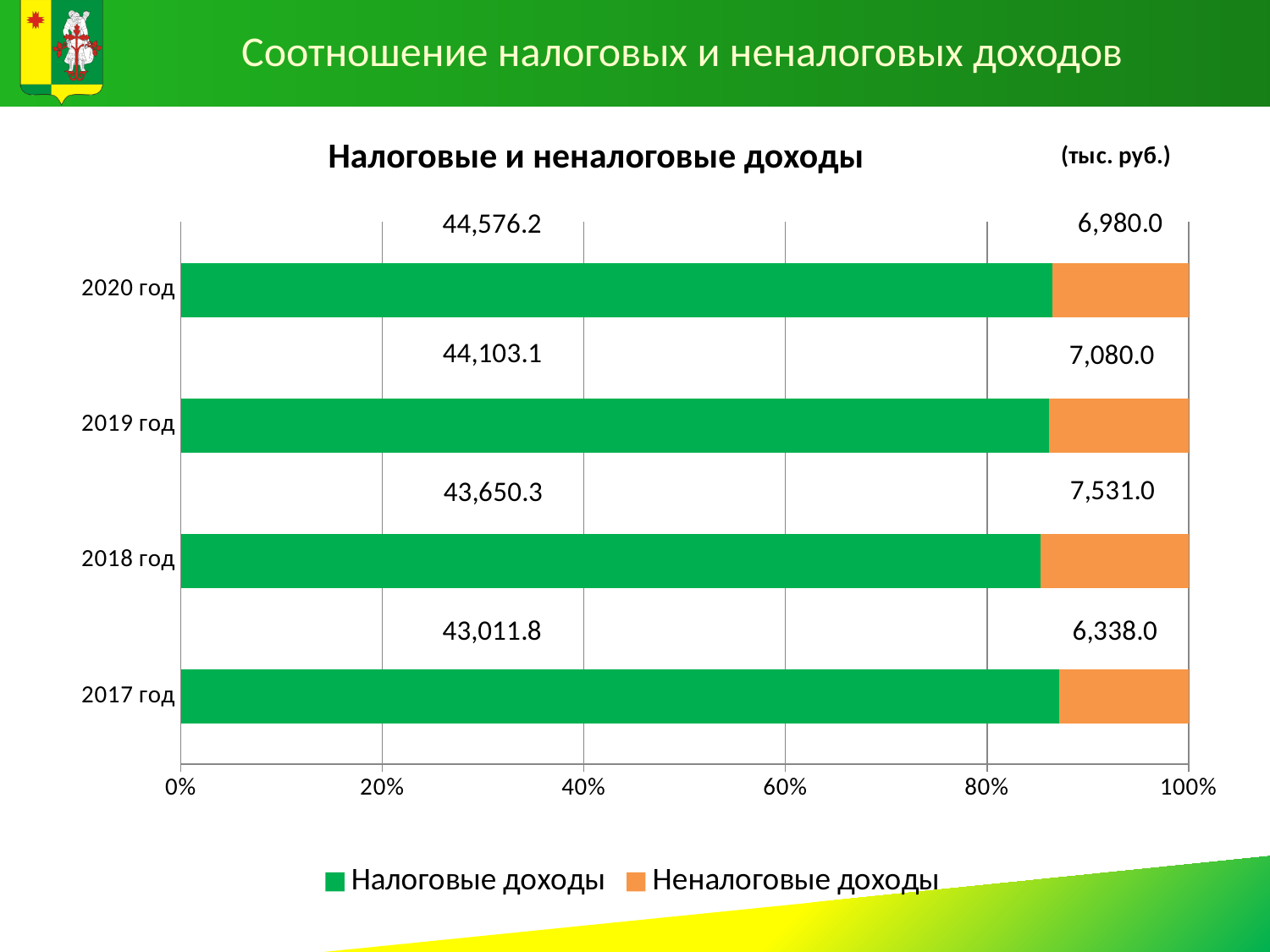
How many series does the legend list? 2 Which year has the highest value of Неналоговые доходы? 2018 год Which is larger: Неналоговые доходы in 2019 год or in 2020 год? 2019 год What kind of chart is shown on the slide? Stacked bar chart Is the share of Налоговые доходы in 2020 год greater or less than 80%? greater What is the difference between Налоговые доходы in 2020 год and in 2017 год? 1,564.4 How many years are shown on the chart? 4 What is the total of Налоговые доходы and Неналоговые доходы for 2020 год? 51,556.2 What is the value of Неналоговые доходы for 2017 год? 6,338.0 Which year has the lowest value of Налоговые доходы? 2017 год What is the value of Налоговые доходы for 2020 год? 44,576.2 What is the value of Неналоговые доходы for 2018 год? 7,531.0